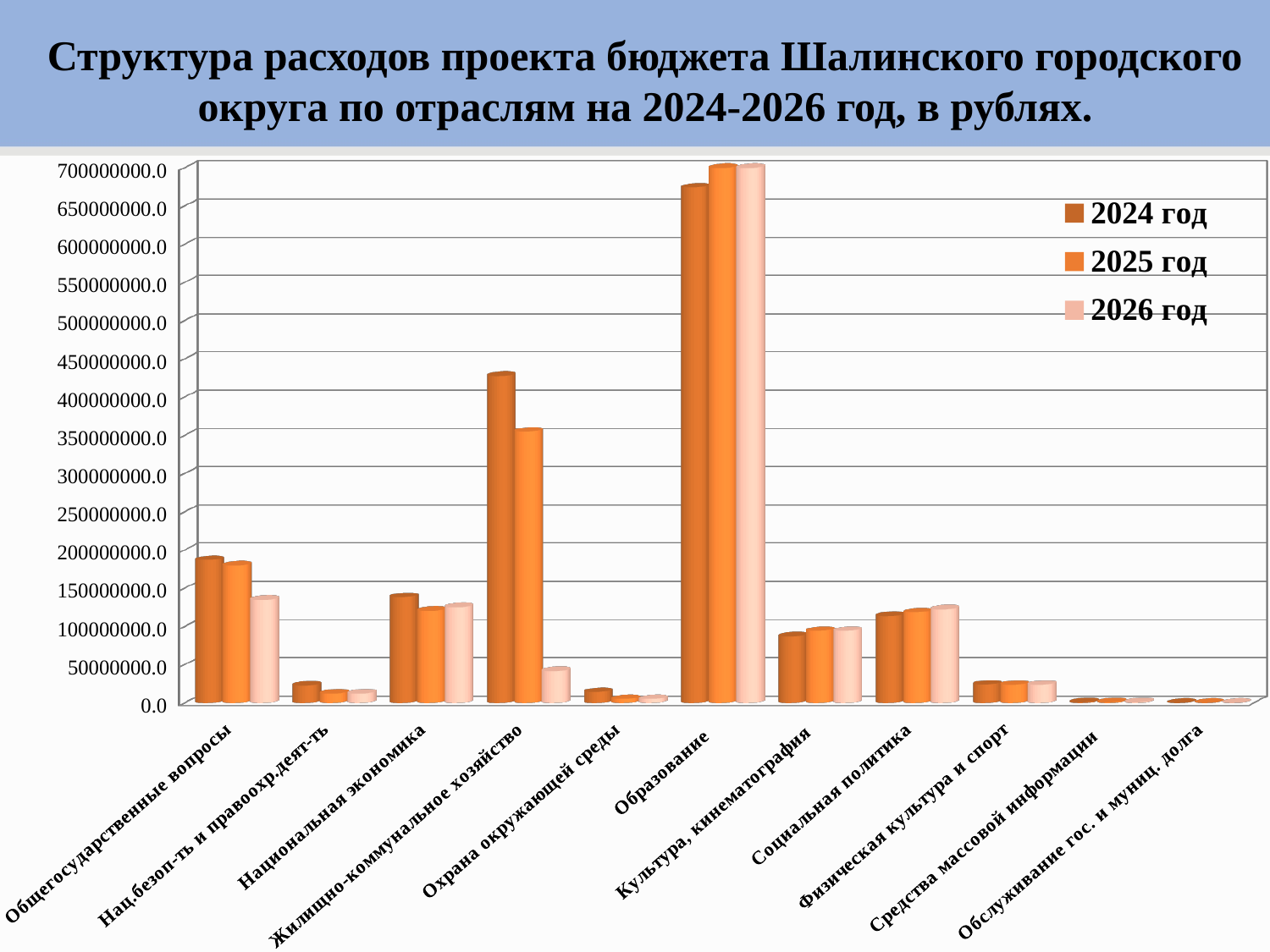
What kind of chart is shown on the slide? bar chart How many categories are shown on the x axis? 11 Is the value for Образование in 2024 год greater or less than 650000000.0? greater Which is larger for Жилищно-коммунальное хозяйство: the value for 2024 год or 2025 год? 2024 год How many series does the legend list? 3 Do the values for Жилищно-коммунальное хозяйство rise or fall from 2024 год to 2026 год? fall Which series is shown in the lightest colour in the legend? 2026 год Is the value for Жилищно-коммунальное хозяйство in 2026 год greater or less than 50000000.0? less Is the value for Культура, кинематография in 2024 год greater or less than 100000000.0? less Which category has the highest value for 2024 год? Образование